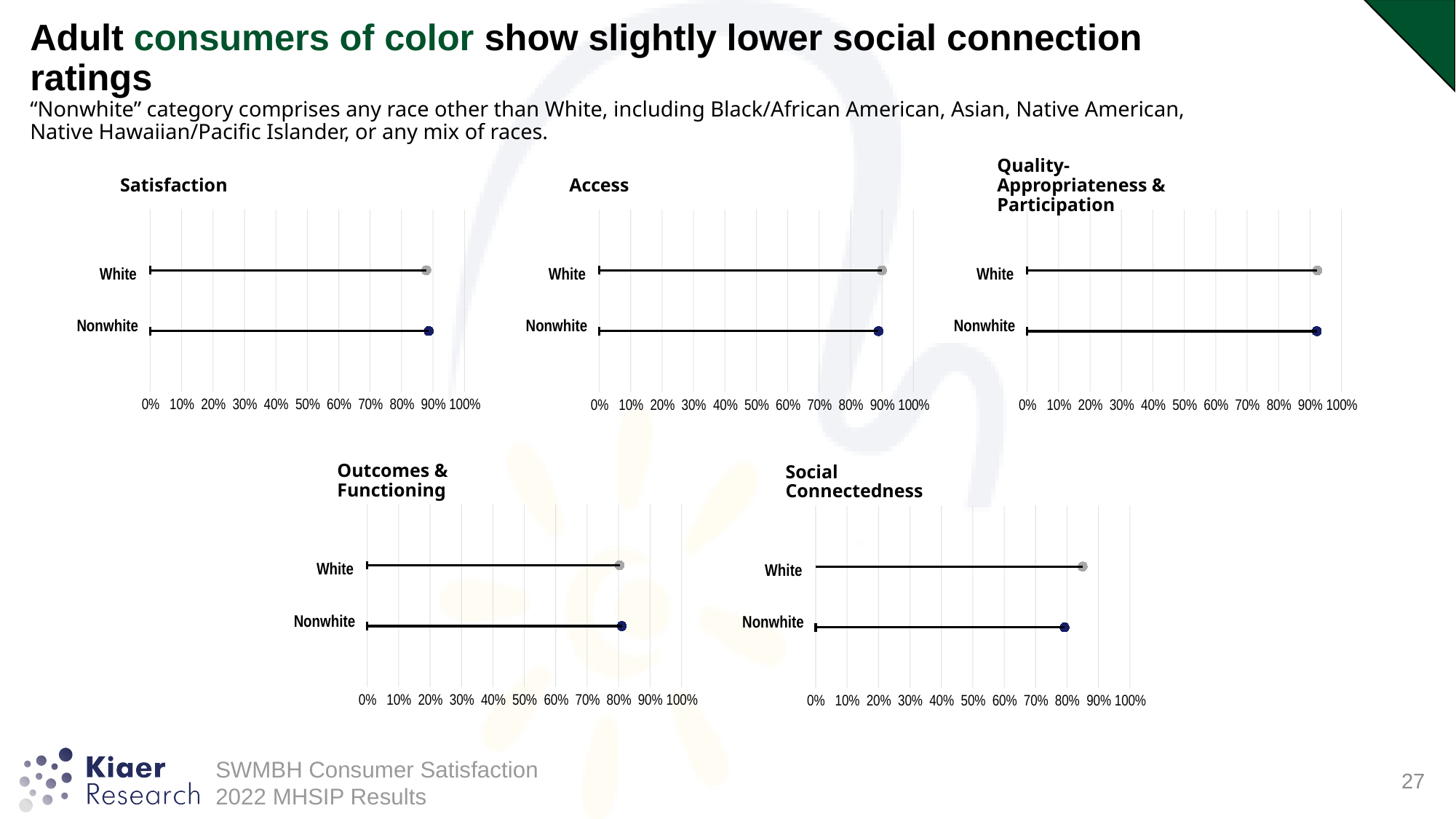
In the Outcomes & Functioning chart, is the value for White greater or less than 90%? less In the Social Connectedness chart, is the value for Nonwhite greater or less than 70%? greater In the Access chart, is the value for Nonwhite greater or less than 80%? greater How many charts are shown on the slide? 5 In the Access chart, what is the highest value shown on the x axis? 100% What is the title of the chart in the bottom right of the slide? Social Connectedness In the Social Connectedness chart, which group has the higher value, White or Nonwhite? White How many categories are shown in the Satisfaction chart? 2